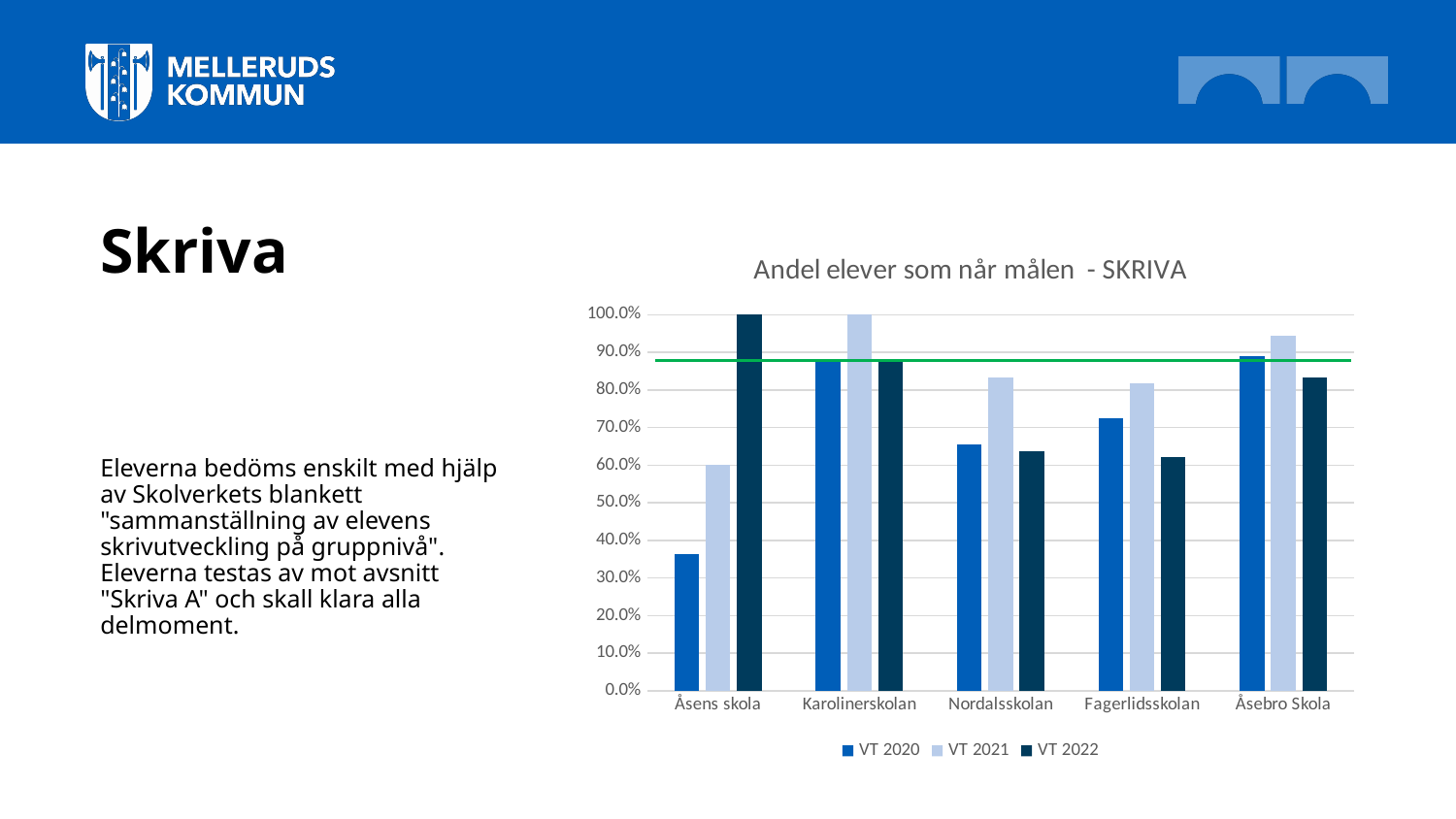
What is the VT 2022 value for Åsens skola? 100.0% Which school has the lowest VT 2020 value? Åsens skola What is the title of the chart? Andel elever som når målen - SKRIVA Is the VT 2020 value for Åsens skola greater or less than 40.0%? less What kind of chart is shown on the slide? bar chart What is the VT 2021 value for Karolinerskolan? 100.0% How many schools (categories) are shown on the x axis of the chart? 5 For Fagerlidsskolan, which is larger: the VT 2021 value or the VT 2022 value? VT 2021 Is the VT 2021 value for Nordalsskolan greater or less than 80.0%? greater Which series are listed in the chart legend? VT 2020, VT 2021, VT 2022 Which school has the highest VT 2022 value? Åsens skola How many series does the chart legend list? 3